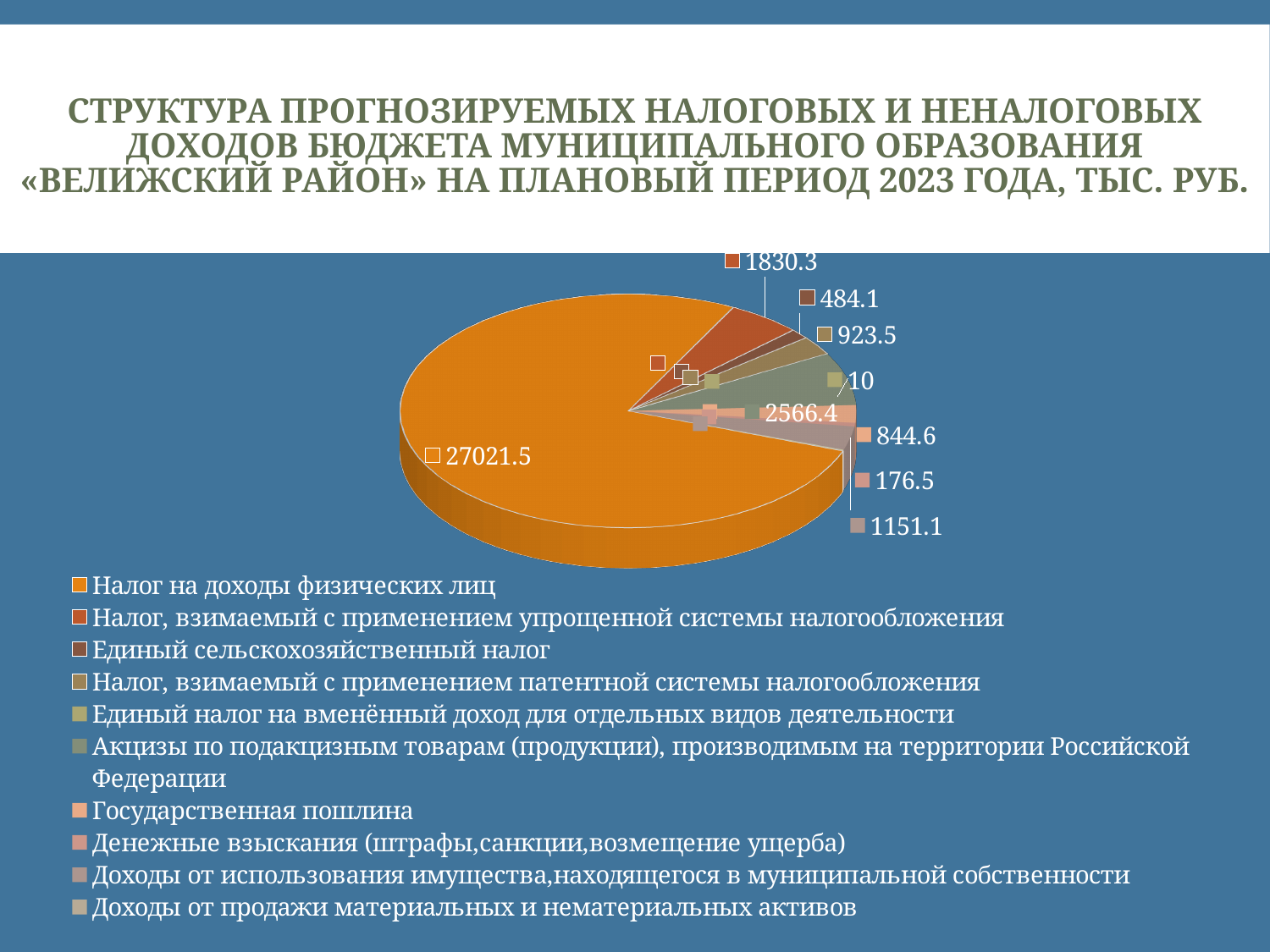
What is the value shown for Налог на доходы физических лиц? 27021.5 Which is larger, the slice labelled 2566.4 or the slice labelled 1830.3? 2566.4 What is the value of the largest slice of the pie chart? 27021.5 Which is larger, the slice labelled 844.6 or the slice labelled 923.5? 923.5 What is the smallest value printed as a data label on the pie chart? 10 Which legend entry corresponds to the large orange slice of the pie chart? Налог на доходы физических лиц Is the value of the largest slice greater or less than 20000? greater What kind of chart is shown on the slide? pie chart What is the difference between the slices labelled 1151.1 and 176.5? 974.6 What is the difference between the slices labelled 1830.3 and 484.1? 1346.2 How many entries does the legend of the pie chart list? 10 In what units are the values on the chart given, according to the slide title? тыс. руб.